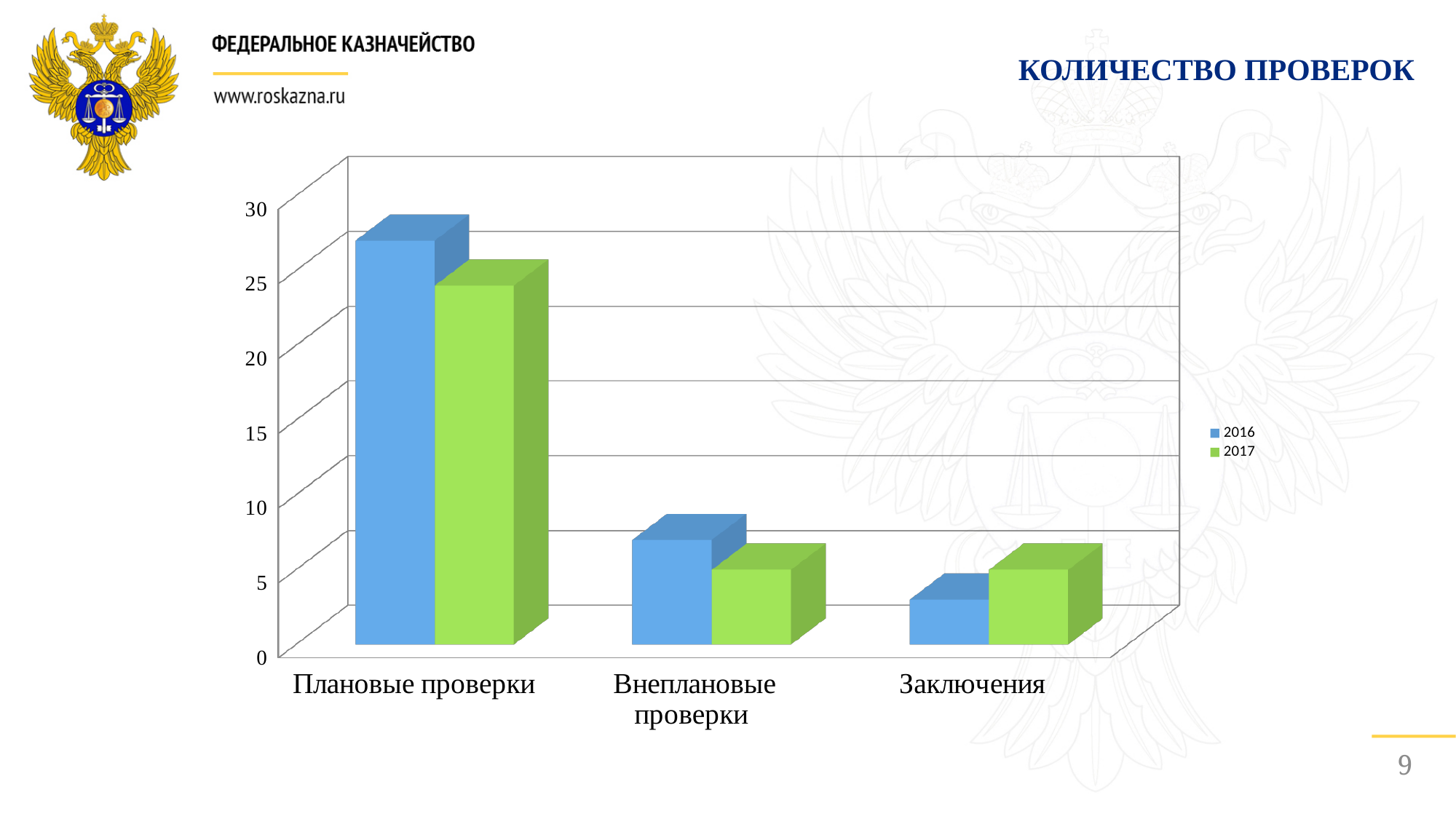
What kind of chart is shown on the slide? bar chart For Заключения, which year has the larger value, 2016 or 2017? 2017 Is the value for Заключения in 2016 greater or less than 5? less Which series is shown in green in the chart? 2017 For Плановые проверки, which year has the larger value, 2016 or 2017? 2016 Which category has the highest value for 2017? Плановые проверки Which category has the highest value for 2016? Плановые проверки What is the title of the slide's chart? КОЛИЧЕСТВО ПРОВЕРОК Which category has the lowest value for 2016? Заключения Is the value for Плановые проверки in 2016 greater or less than 25? greater How many series does the legend list? 2 How many categories are shown on the x axis of the chart? 3